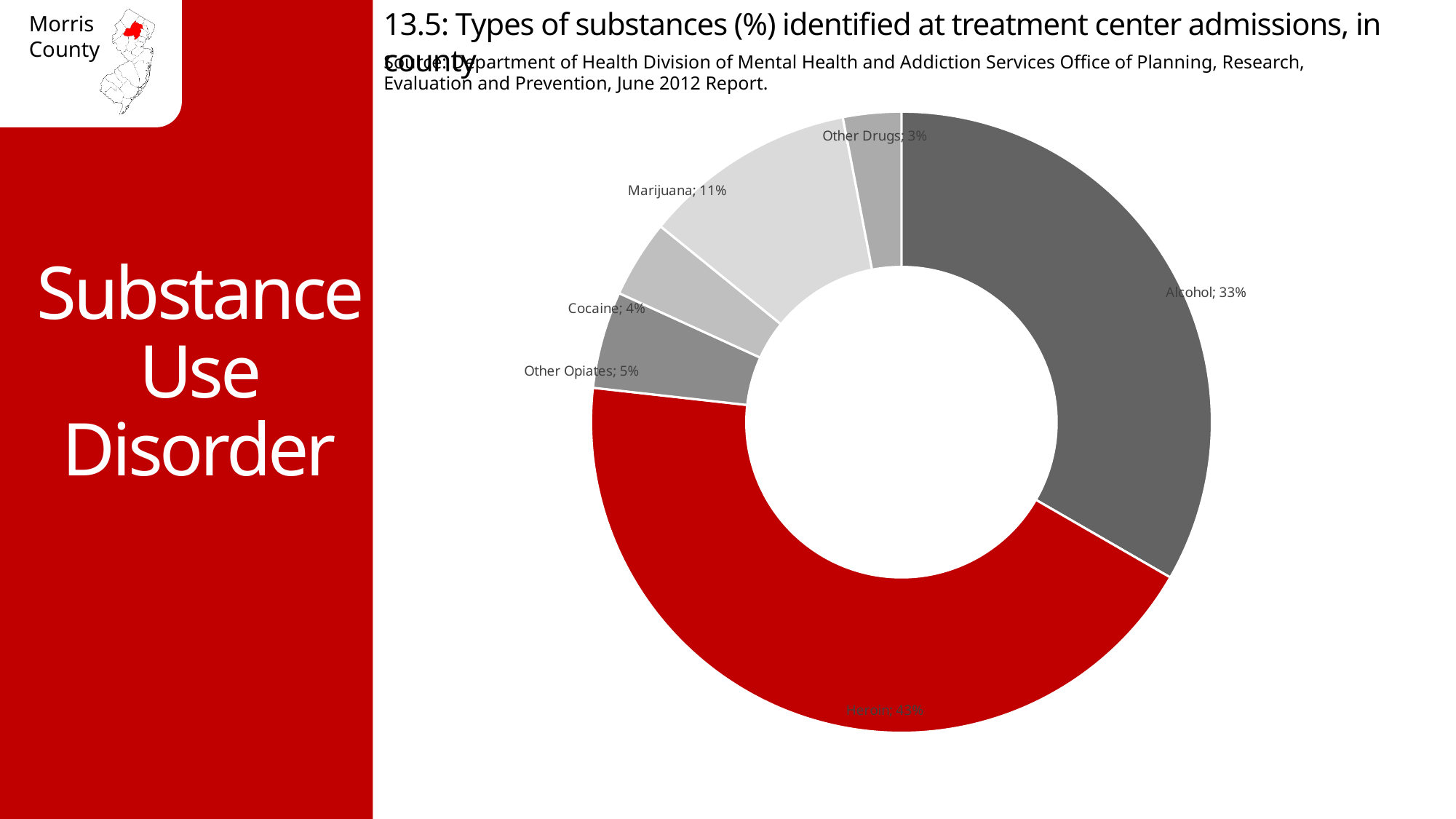
What is the difference in percentage points between Heroin and Alcohol? 10 Which substance has the largest share of treatment center admissions? Heroin What percentage of treatment center admissions is identified as Alcohol? 33% How many substance categories are shown in the chart? 6 What percentage is shown for Other Opiates? 5% Which substance has the smallest share of treatment center admissions? Other Drugs What percentage is shown for Marijuana? 11% What is the difference in percentage points between Marijuana and Cocaine? 7 What percentage is shown for Other Drugs? 3% What kind of chart is used on this slide? doughnut chart Which is larger, the share for Alcohol or the share for Marijuana? Alcohol What percentage is shown for Cocaine? 4%